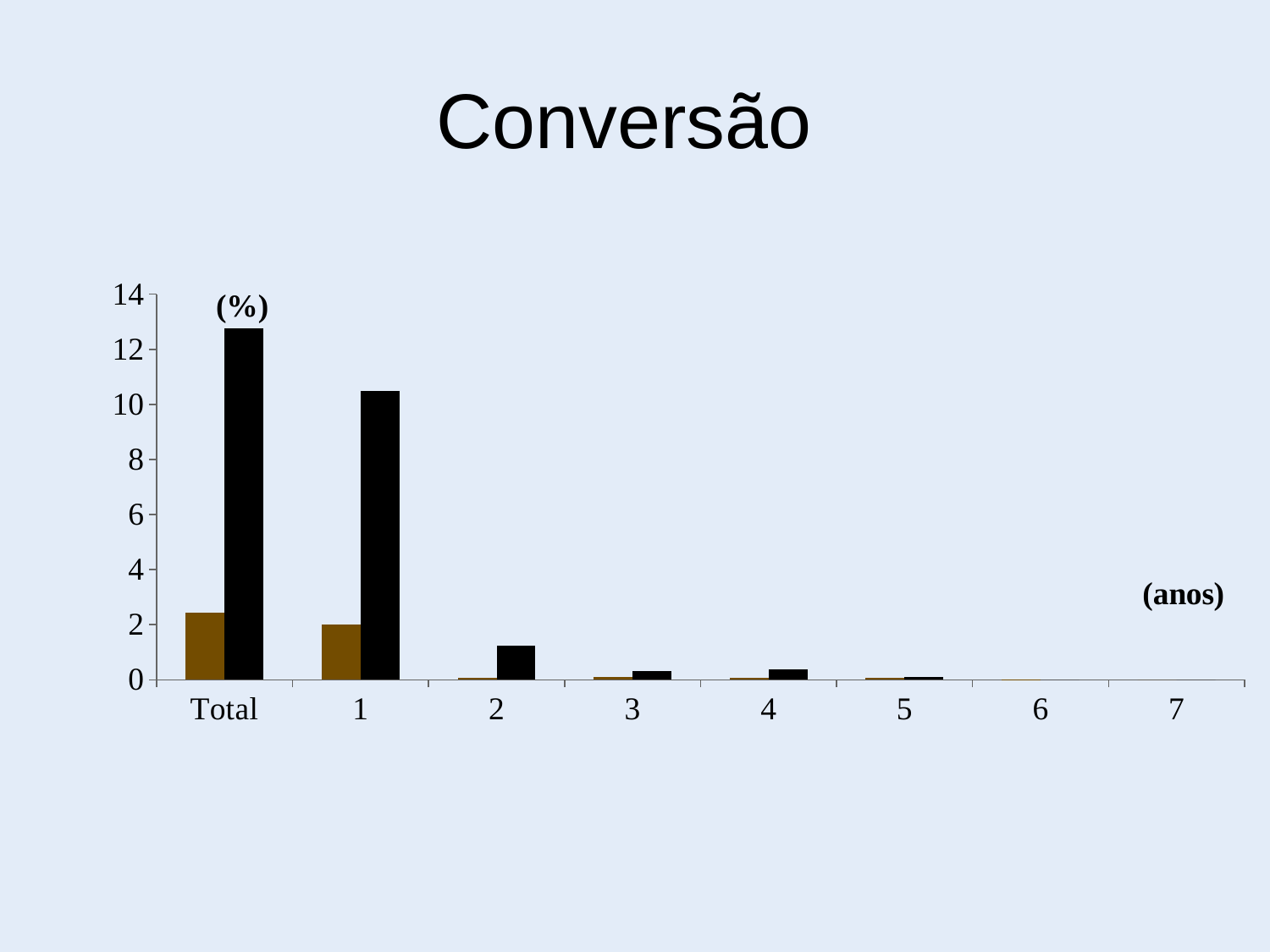
Do the black bars generally rise or fall from category 1 to category 7? fall For the Total category, which bar is taller, the brown one or the black one? the black one Is the black bar for Total greater or less than 12? greater Is the black bar for category 2 greater or less than 2? less What is the title of the slide? Conversão How many categories are shown on the x axis of the chart? 8 What unit is indicated for the vertical axis of the chart? (%) What kind of chart is shown on the slide? bar chart Is the brown bar for Total greater or less than 2? greater Which category has the tallest black bar? Total Which black bar is taller, the one for Total or the one for category 1? Total